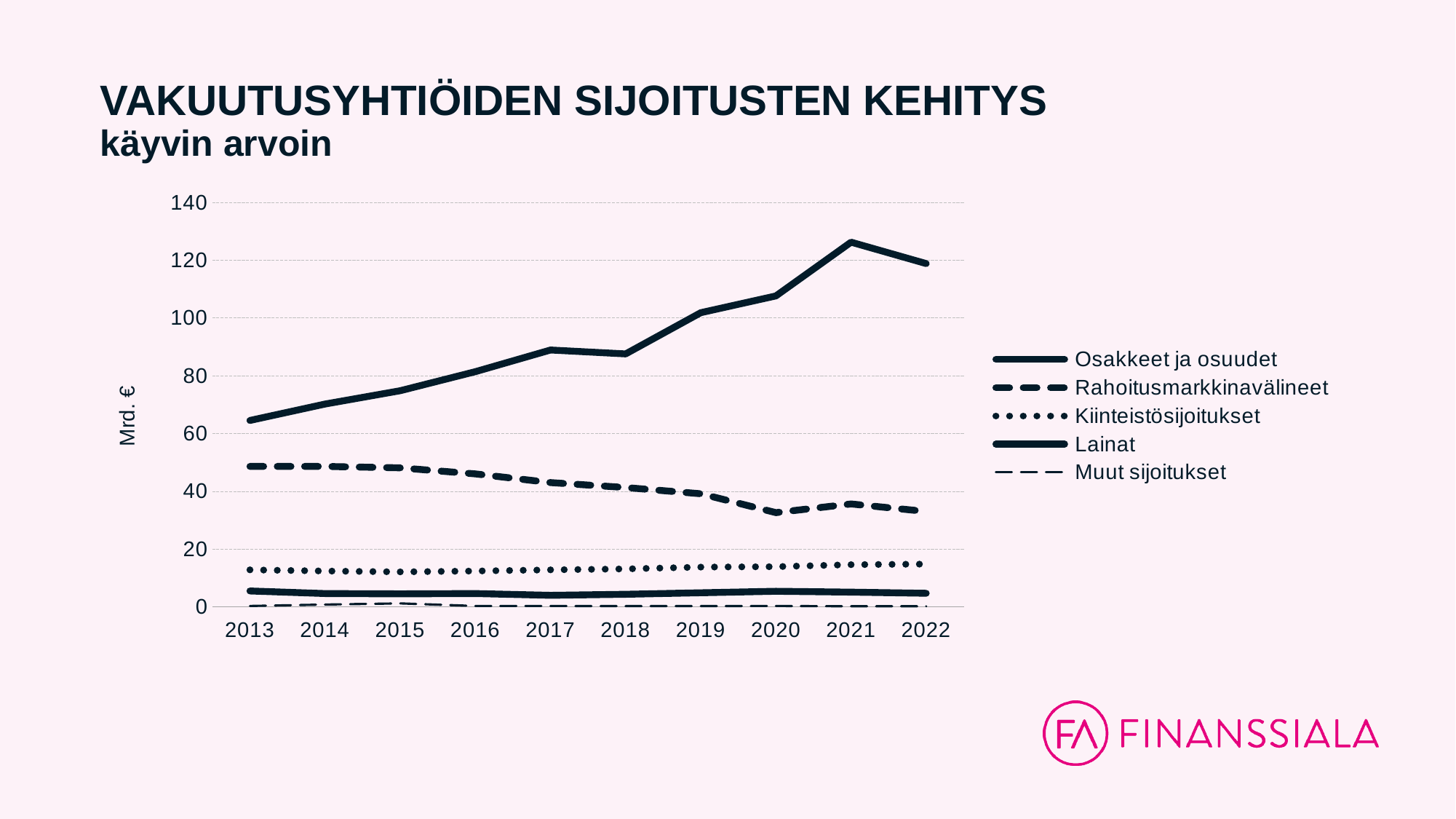
Is the value for Rahoitusmarkkinavälineet in 2013 greater or less than 40? greater Which series has the lowest values across all years? Muut sijoitukset Does the Rahoitusmarkkinavälineet series rise or fall from 2013 to 2020? fall What kind of chart is shown on the slide? line chart In which year does the Osakkeet ja osuudet series reach its highest value? 2021 Is the value for Rahoitusmarkkinavälineet in 2020 greater or less than 40? less Is the value for Osakkeet ja osuudet in 2021 greater or less than 120? greater How many series does the legend list? 5 How many years are shown on the x axis? 10 In 2022, which is larger: Osakkeet ja osuudet or Rahoitusmarkkinavälineet? Osakkeet ja osuudet